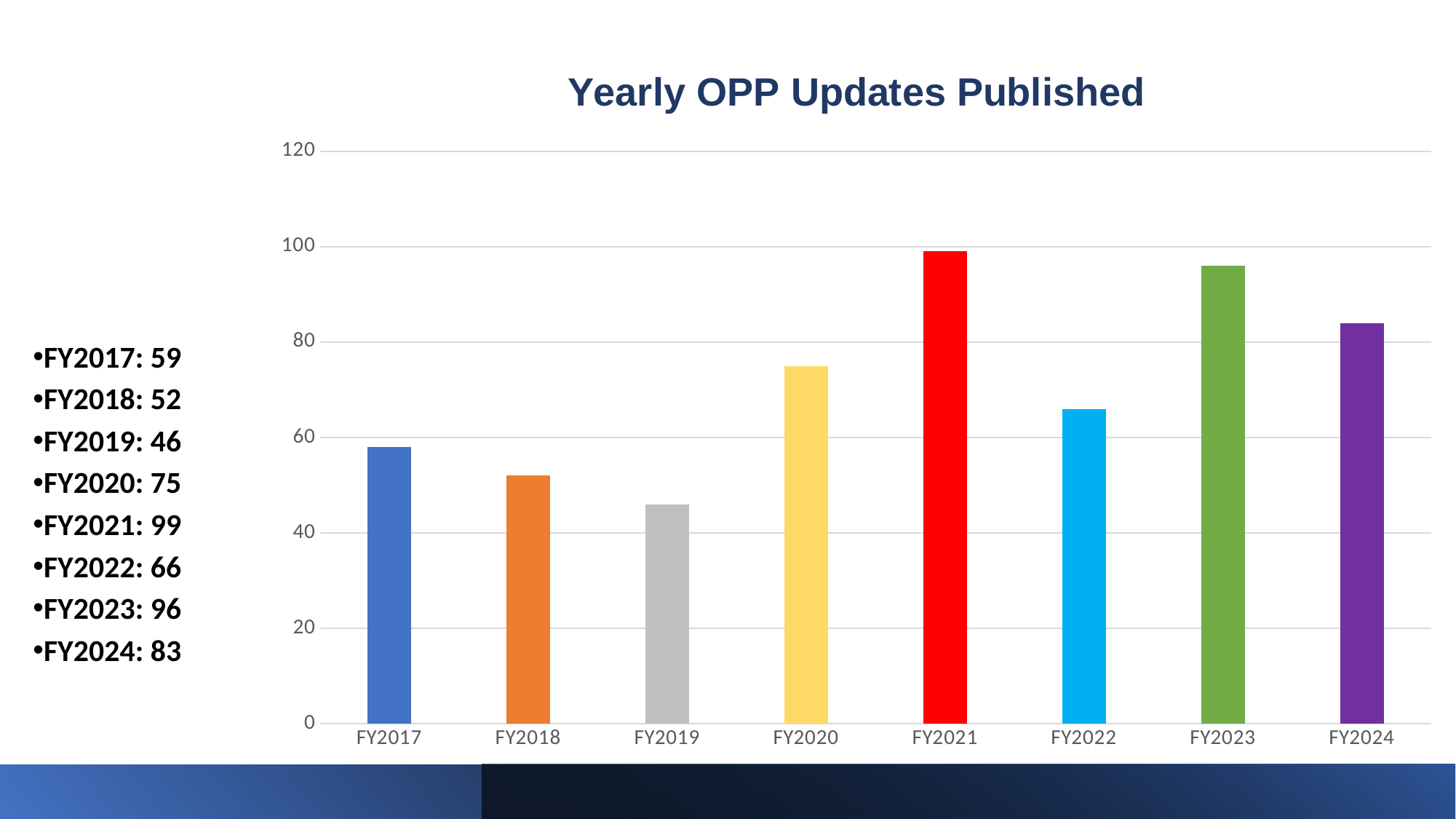
What kind of chart is shown on the slide? Bar chart What is the value for FY2019 in the Yearly OPP Updates Published chart? 46 Which is larger, the value for FY2020 or the value for FY2022? FY2020 What is the title of the chart on the slide? Yearly OPP Updates Published How many fiscal years are shown on the x axis of the chart? 8 Which fiscal year has the highest number of OPP updates published? FY2021 Which fiscal year has the lowest number of OPP updates published? FY2019 What is the value for FY2021 in the Yearly OPP Updates Published chart? 99 What is the difference between the values for FY2021 and FY2019? 53 What is the difference between the values for FY2023 and FY2022? 30 Is the value for FY2023 greater or less than 80? greater